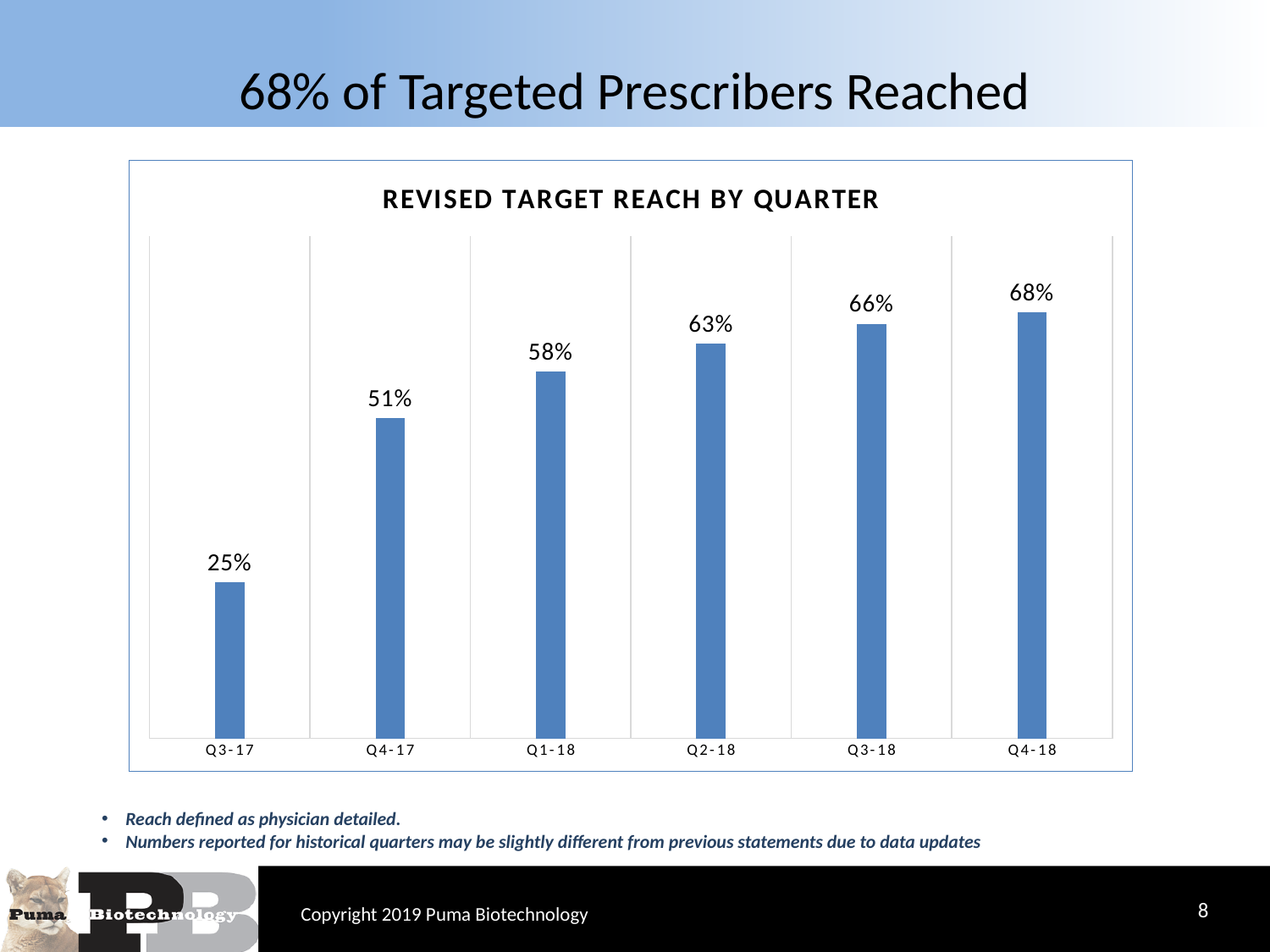
What is the revised target reach for Q4-18? 68% Which quarter has the lowest target reach? Q3-17 What is the revised target reach for Q3-17? 25% How many quarters are shown in the chart? 6 What is the difference in target reach between Q4-17 and Q3-17? 26% What is the revised target reach for Q1-18? 58% What is the title of the chart? Revised Target Reach by Quarter What is the difference in target reach between Q4-18 and Q2-18? 5% Do the target reach values rise or fall from Q3-17 to Q4-18? Rise Which quarter has a higher target reach, Q2-18 or Q1-18? Q2-18 What kind of chart is shown on the slide? Bar chart Which quarter has the highest target reach? Q4-18